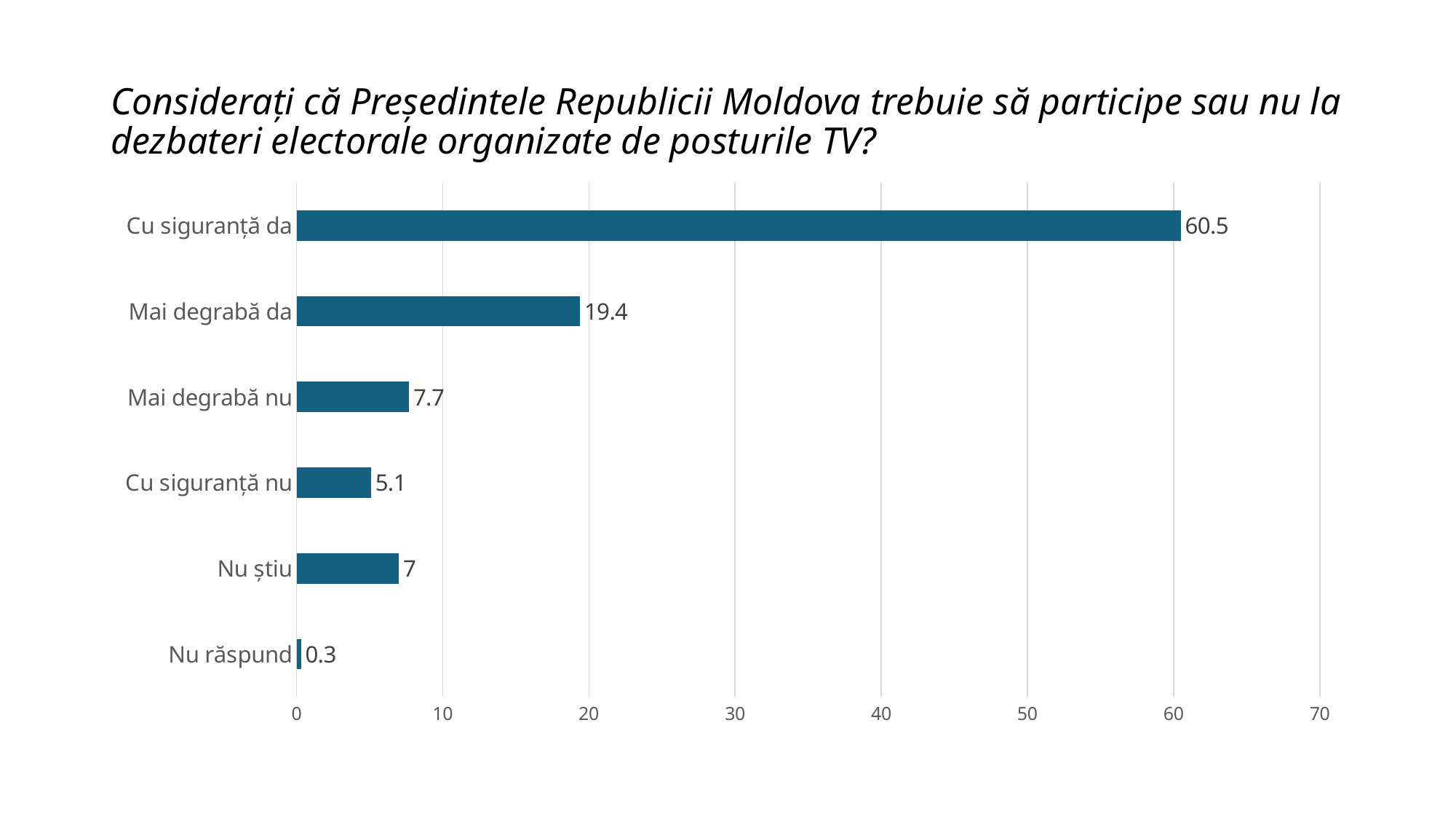
What is the difference between the values for "Cu siguranță da" and "Mai degrabă da"? 41.1 What is the value for "Nu răspund"? 0.3 Which is larger, the value for "Nu știu" or the value for "Cu siguranță nu"? Nu știu What is the value for "Mai degrabă da"? 19.4 What is the value for "Nu știu"? 7 Which category has the lowest value? Nu răspund What is the difference between the values for "Mai degrabă nu" and "Cu siguranță nu"? 2.6 How many categories are shown in the chart? 6 Which category has the highest value? Cu siguranță da What kind of chart is shown on the slide? Bar chart What is the value for "Cu siguranță da"? 60.5 Is the value for "Cu siguranță da" greater or less than 50? greater